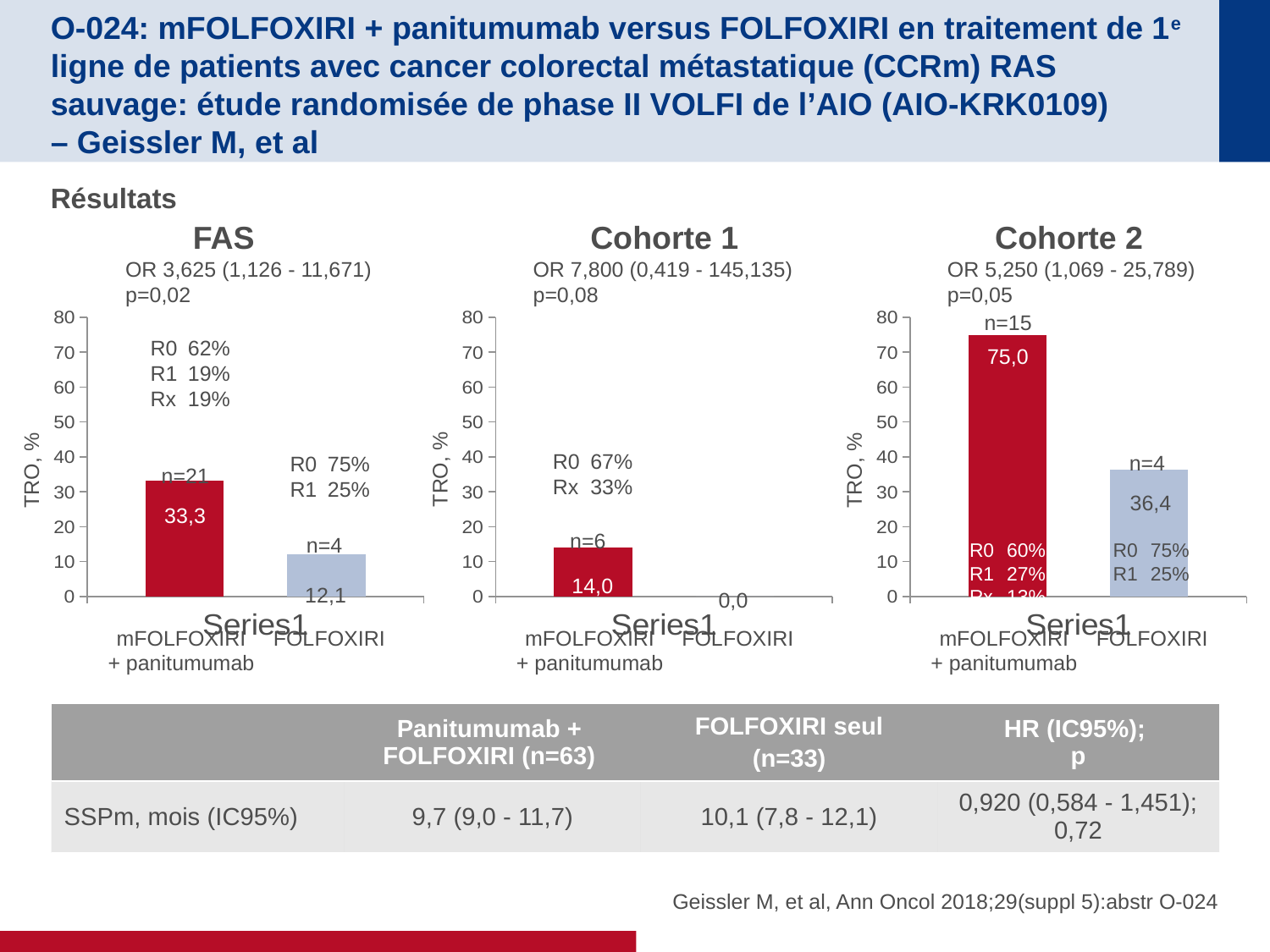
In the Cohorte 2 chart, what is the TRO value for mFOLFOXIRI + panitumumab? 75,0 In the Cohorte 1 chart, what is the TRO value for FOLFOXIRI? 0,0 In the Cohorte 2 chart, what is the TRO value for FOLFOXIRI? 36,4 In the Cohorte 1 chart, is the TRO for mFOLFOXIRI + panitumumab greater or less than 20? less In the FAS chart, what is the TRO value for mFOLFOXIRI + panitumumab? 33,3 In the Cohorte 2 chart, which treatment arm has the higher TRO? mFOLFOXIRI + panitumumab How many bars are plotted in the Cohorte 2 chart? 2 In the Cohorte 2 chart, what is the difference in TRO between mFOLFOXIRI + panitumumab and FOLFOXIRI? 38,6 In the FAS chart, what is the difference in TRO between mFOLFOXIRI + panitumumab and FOLFOXIRI? 21,2 What type of chart is used for the FAS results? Bar chart In the FAS chart, what is the TRO value for FOLFOXIRI? 12,1 In the Cohorte 1 chart, what is the TRO value for mFOLFOXIRI + panitumumab? 14,0